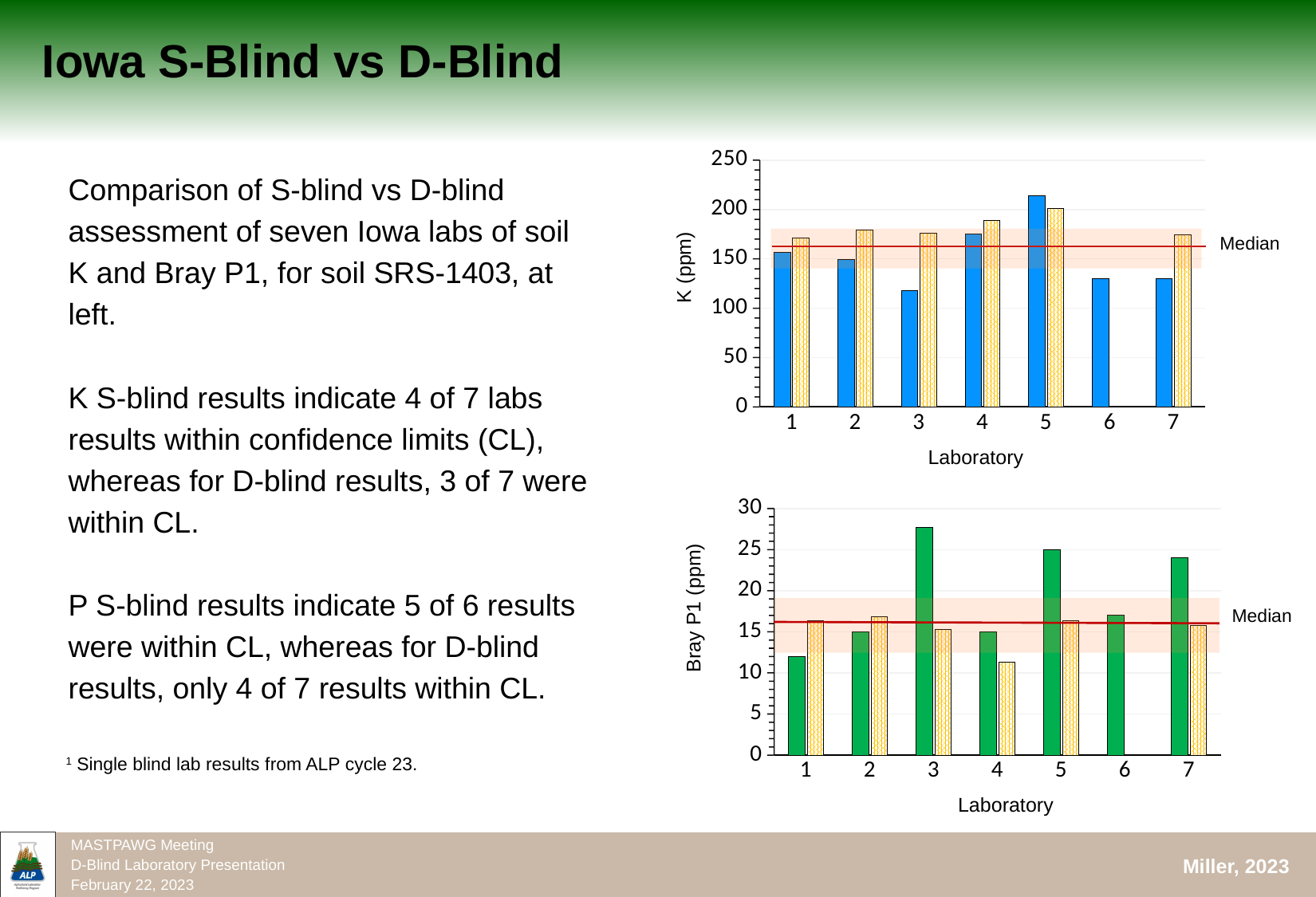
What kind of chart is the top chart (K (ppm))? bar chart In the top chart (K (ppm)), is the solid blue bar for laboratory 5 greater or less than 200? greater In the top chart (K (ppm)), which laboratory has the shortest solid blue bar? 3 In the bottom chart (Bray P1 (ppm)), which solid green bar is taller, laboratory 3 or laboratory 5? laboratory 3 In the top chart (K (ppm)), which laboratory has the tallest solid blue bar? 5 In the top chart (K (ppm)), is the solid blue bar for laboratory 3 greater or less than 150? less What is the y-axis title of the bottom chart? Bray P1 (ppm) In the bottom chart (Bray P1 (ppm)), which laboratory has the shortest solid green bar? 1 In the bottom chart (Bray P1 (ppm)), which laboratory has the tallest solid green bar? 3 In the top chart (K (ppm)), how many laboratories are shown on the x axis? 7 What does the red horizontal line in each chart represent? Median In the bottom chart (Bray P1 (ppm)), is the patterned bar for laboratory 4 greater or less than 15? less